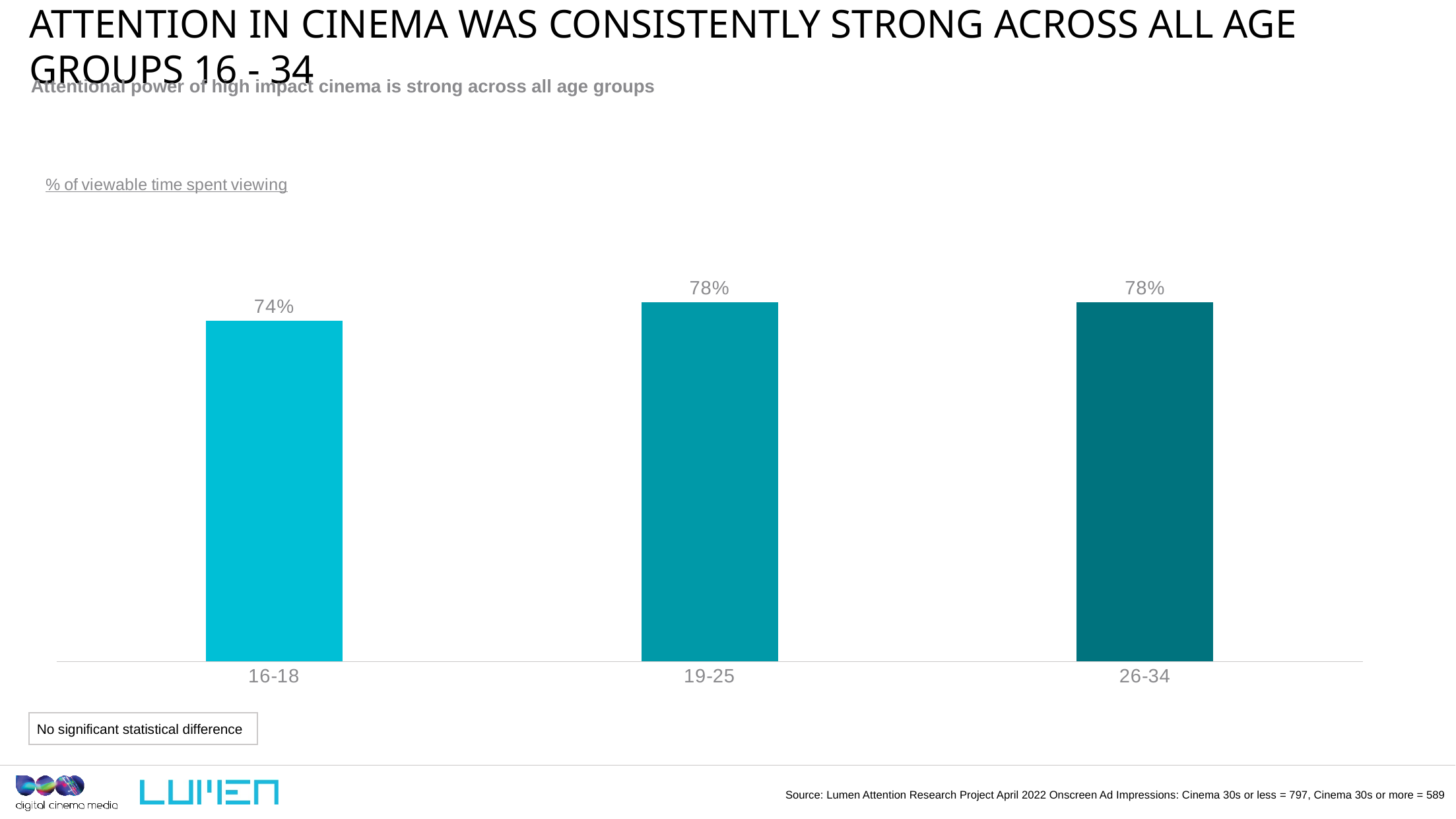
What is the % of viewable time spent viewing for the 26-34 age group? 78% How many age groups are shown in the chart? 3 What is the % of viewable time spent viewing for the 16-18 age group? 74% Which age group has the lowest % of viewable time spent viewing? 16-18 Which has a higher % of viewable time spent viewing, the 16-18 or the 26-34 age group? 26-34 What does the note box below the chart say? No significant statistical difference What is the difference in % of viewable time spent viewing between the 19-25 and 16-18 age groups? 4% Do the values rise or fall from the 16-18 group to the 19-25 group? Rise What is the % of viewable time spent viewing for the 19-25 age group? 78% What metric does the chart plot, according to the label above it? % of viewable time spent viewing What kind of chart is shown on the slide? Bar chart